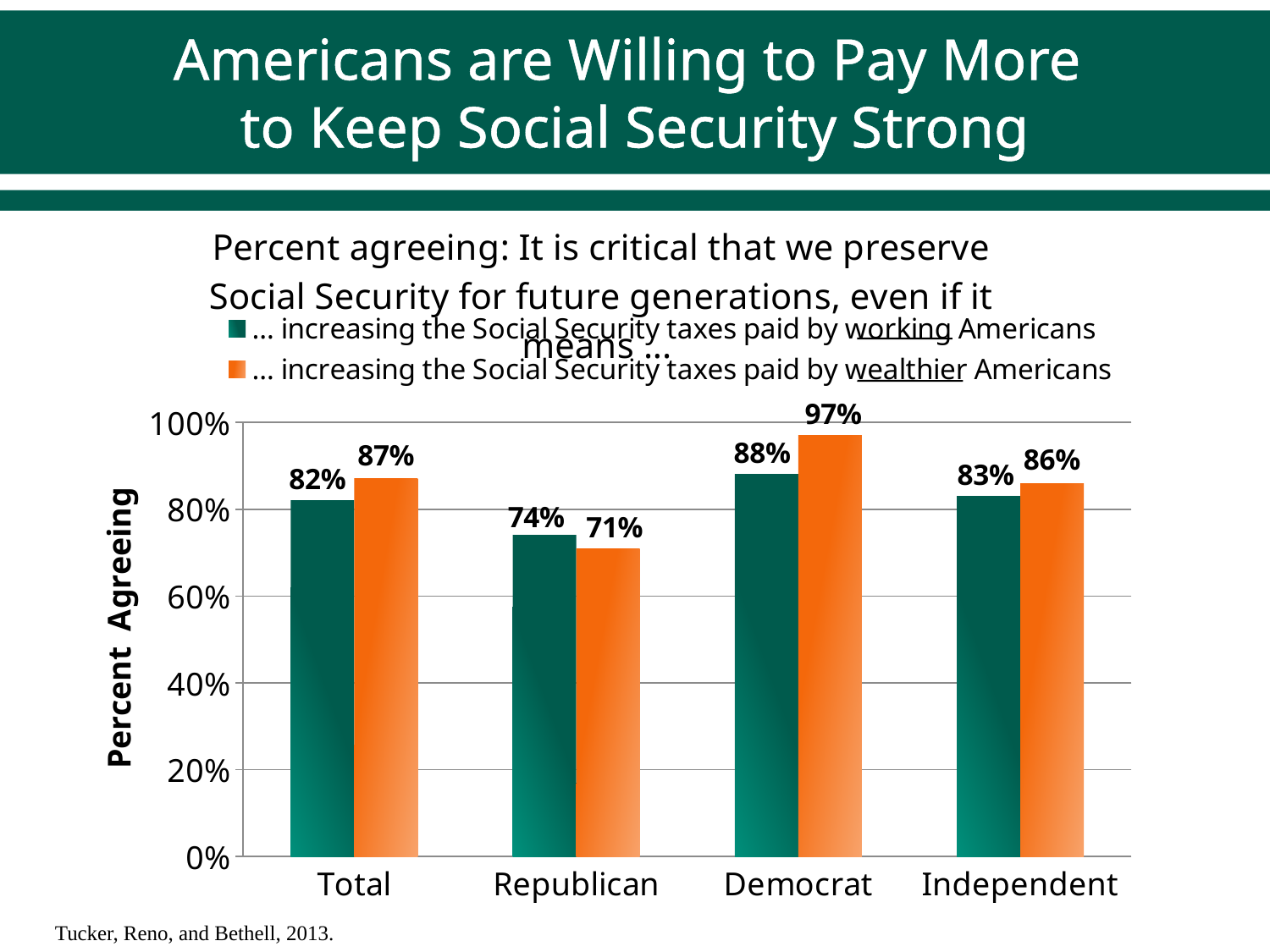
What is the label of the y axis? Percent Agreeing What is the value for Independent in the 'increasing the Social Security taxes paid by wealthier Americans' series? 86% What percent of Democrats agree with increasing Social Security taxes paid by wealthier Americans? 97% Which category has the highest value for the 'wealthier Americans' series? Democrat What kind of chart is shown on the slide? bar chart How many categories are shown on the x axis? 4 For Republican, which is larger: the 'working Americans' value or the 'wealthier Americans' value? working Americans (74%) How many series does the legend list? 2 Which category has the lowest value for the 'working Americans' series? Republican What is the Total value for the 'increasing the Social Security taxes paid by working Americans' series? 82% What percent of Republicans agree with increasing Social Security taxes paid by working Americans? 74% What is the difference between the 'wealthier Americans' and 'working Americans' values for Democrat? 9%